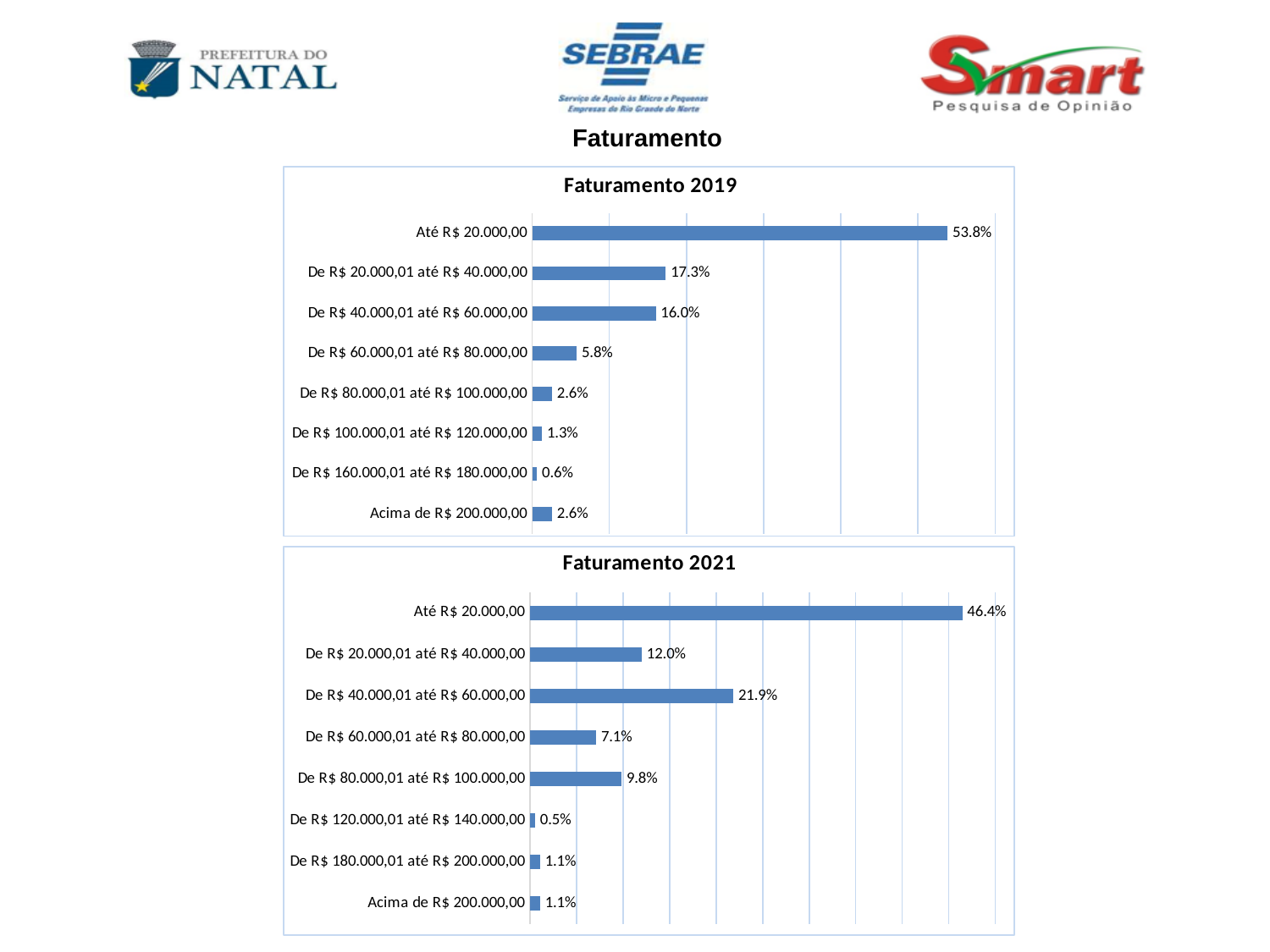
In the 'Faturamento 2019' chart, which is larger: 'De R$ 20.000,01 até R$ 40.000,00' or 'De R$ 40.000,01 até R$ 60.000,00'? De R$ 20.000,01 até R$ 40.000,00 In the 'Faturamento 2019' chart, which category has the lowest value? De R$ 160.000,01 até R$ 180.000,00 In the 'Faturamento 2019' chart, what is the value for 'Até R$ 20.000,00'? 53.8% In the 'Faturamento 2019' chart, what is the value for 'Acima de R$ 200.000,00'? 2.6% What kind of chart is 'Faturamento 2021'? Bar chart In the 'Faturamento 2021' chart, what is the difference between 'Até R$ 20.000,00' and 'De R$ 20.000,01 até R$ 40.000,00'? 34.4% In the 'Faturamento 2021' chart, what is the value for 'De R$ 40.000,01 até R$ 60.000,00'? 21.9% What is the title of the lower chart on the slide? Faturamento 2021 How many categories are shown in the 'Faturamento 2019' chart? 8 In the 'Faturamento 2021' chart, which category has the lowest value? De R$ 120.000,01 até R$ 140.000,00 In the 'Faturamento 2019' chart, which category has the highest value? Até R$ 20.000,00 In the 'Faturamento 2021' chart, which is larger: 'De R$ 60.000,01 até R$ 80.000,00' or 'De R$ 80.000,01 até R$ 100.000,00'? De R$ 80.000,01 até R$ 100.000,00